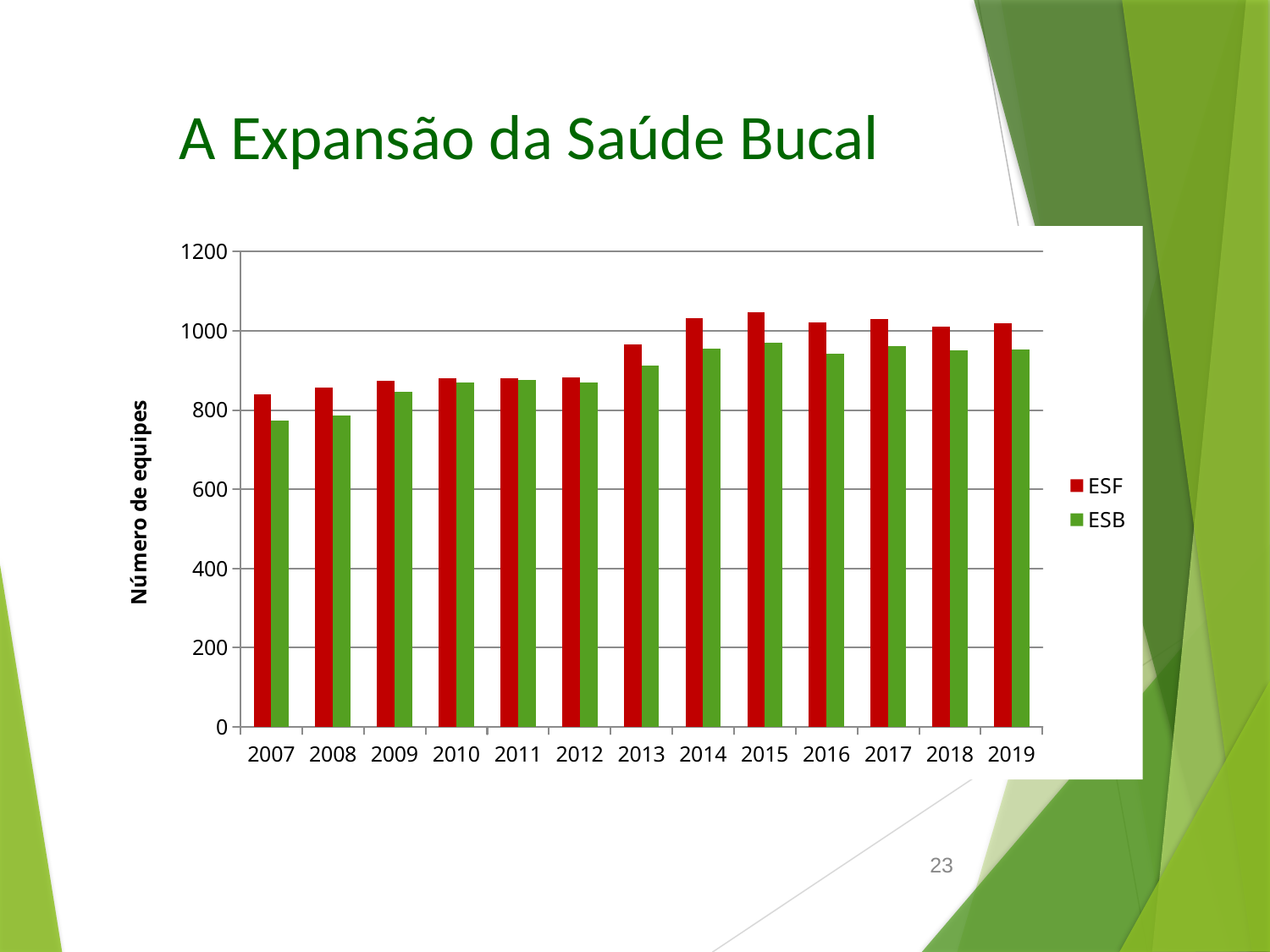
Which year has the lowest ESF value? 2007 How many years are shown on the x axis? 13 In 2007, which is larger, ESF or ESB? ESF Is the ESB value for 2007 greater or less than 800? less Is the ESB value for 2013 greater or less than 1000? less Is the ESF value for 2015 greater or less than 1000? greater Which year has the highest ESF value? 2015 What kind of chart is shown on the slide? bar chart How many series does the legend list? 2 Which year has the lowest ESB value? 2007 What is the title of the vertical axis? Número de equipes Do the ESF values generally rise or fall from 2007 to 2019? rise